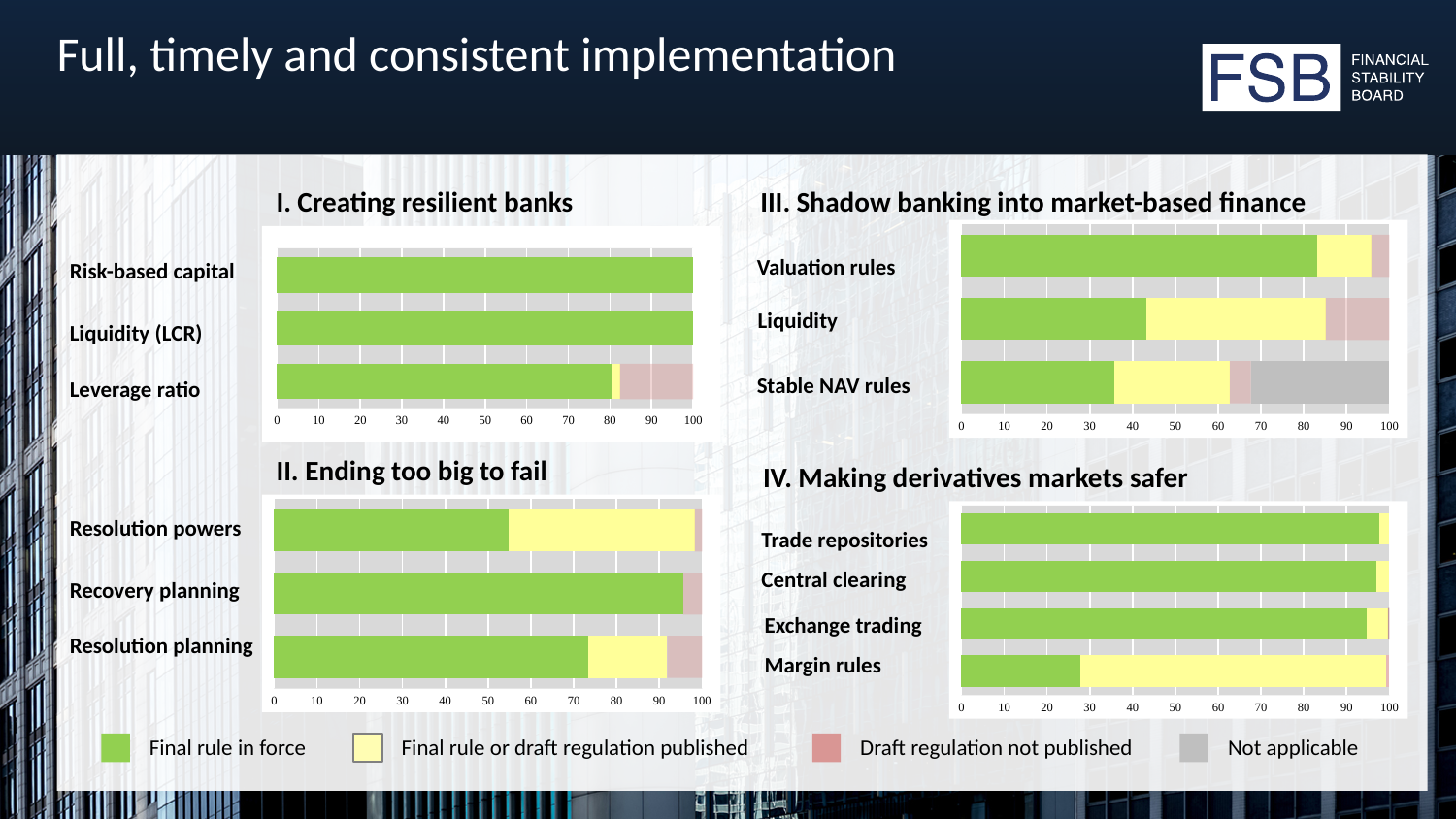
In the 'IV. Making derivatives markets safer' chart, which category has the smallest 'Final rule in force' segment? Margin rules How many categories are shown in the 'II. Ending too big to fail' chart? 3 In the 'IV. Making derivatives markets safer' chart, is the 'Final rule in force' value for Margin rules greater or less than 40? less In the 'I. Creating resilient banks' chart, is the 'Final rule in force' value for Leverage ratio greater or less than 70? greater In the 'III. Shadow banking into market-based finance' chart, which has the larger 'Final rule in force' segment: Valuation rules or Liquidity? Valuation rules In the 'III. Shadow banking into market-based finance' chart, which category has the smallest 'Final rule in force' segment? Stable NAV rules What kind of chart is used under 'I. Creating resilient banks'? Stacked bar chart Which category on the slide shows a 'Not applicable' segment? Stable NAV rules In the 'II. Ending too big to fail' chart, which category has the largest 'Final rule in force' segment? Recovery planning How many series does the legend at the bottom of the slide list? 4 How many categories are shown in the 'IV. Making derivatives markets safer' chart? 4 In the 'II. Ending too big to fail' chart, is the 'Final rule in force' value for Resolution powers greater or less than 70? less